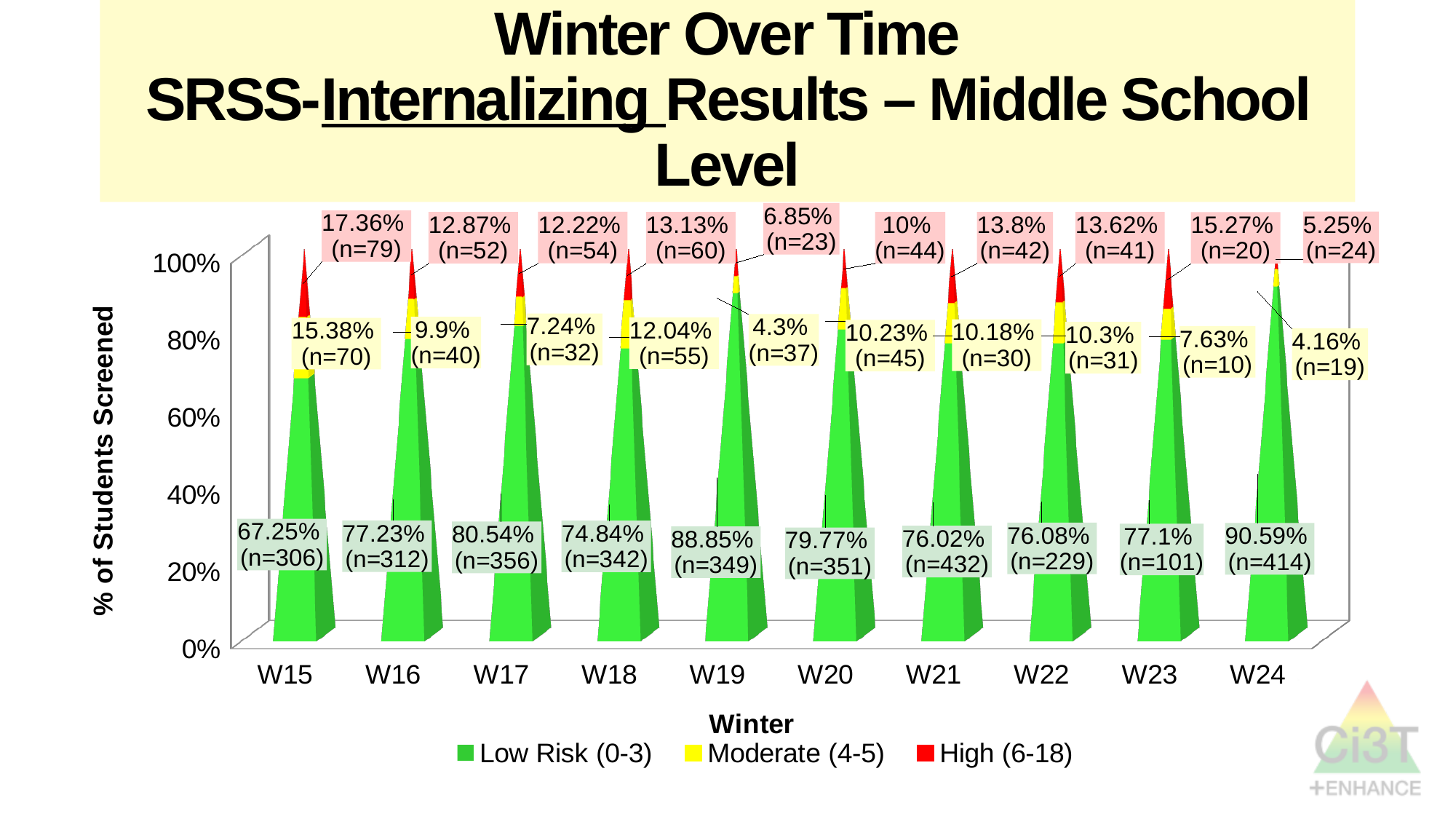
What is the difference between the Low Risk (0-3) percentages in W19 and W15? 21.6% What percentage of students were High (6-18) in W15? 17.36% Which winter has the lowest High (6-18) percentage? W24 Which is larger, the High (6-18) percentage in W23 or in W20? W23 How many series does the legend list? 3 What percentage of students were Low Risk (0-3) in W24? 90.59% What percentage of students were Moderate (4-5) in W18? 12.04% How many students were in the Low Risk (0-3) group in W21? n=432 How many winters are shown on the x axis? 10 Which winter has the lowest Low Risk (0-3) percentage? W15 What is the label of the y axis? % of Students Screened Which winter has the highest Low Risk (0-3) percentage? W24